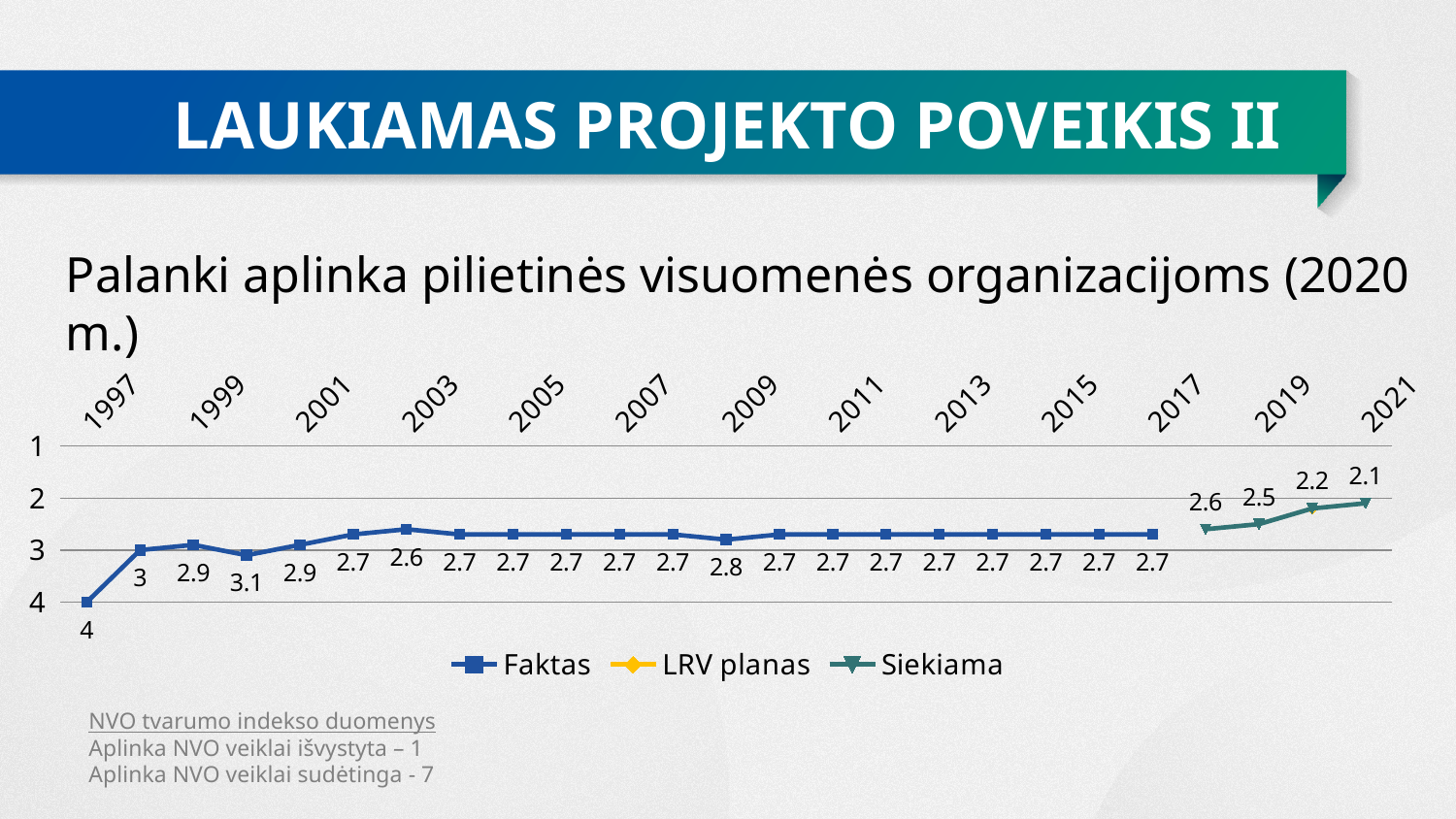
What kind of chart is shown on the slide? Line chart Which is larger, the Siekiama value for 2019 or for 2021? 2019 What is the Siekiama value for 2021? 2.1 In which year is the Faktas value highest? 1997 How many data points does the Siekiama series have? 4 How many series does the legend list? 3 What is the Faktas value for 2003? 2.6 Do the Siekiama values rise or fall from 2018 to 2021? Fall In which year is the Faktas value lowest? 2003 What is the Siekiama value for 2019? 2.5 What is the Faktas value for 1997? 4 What is the difference between the Faktas value in 1997 and in 2017? 1.3